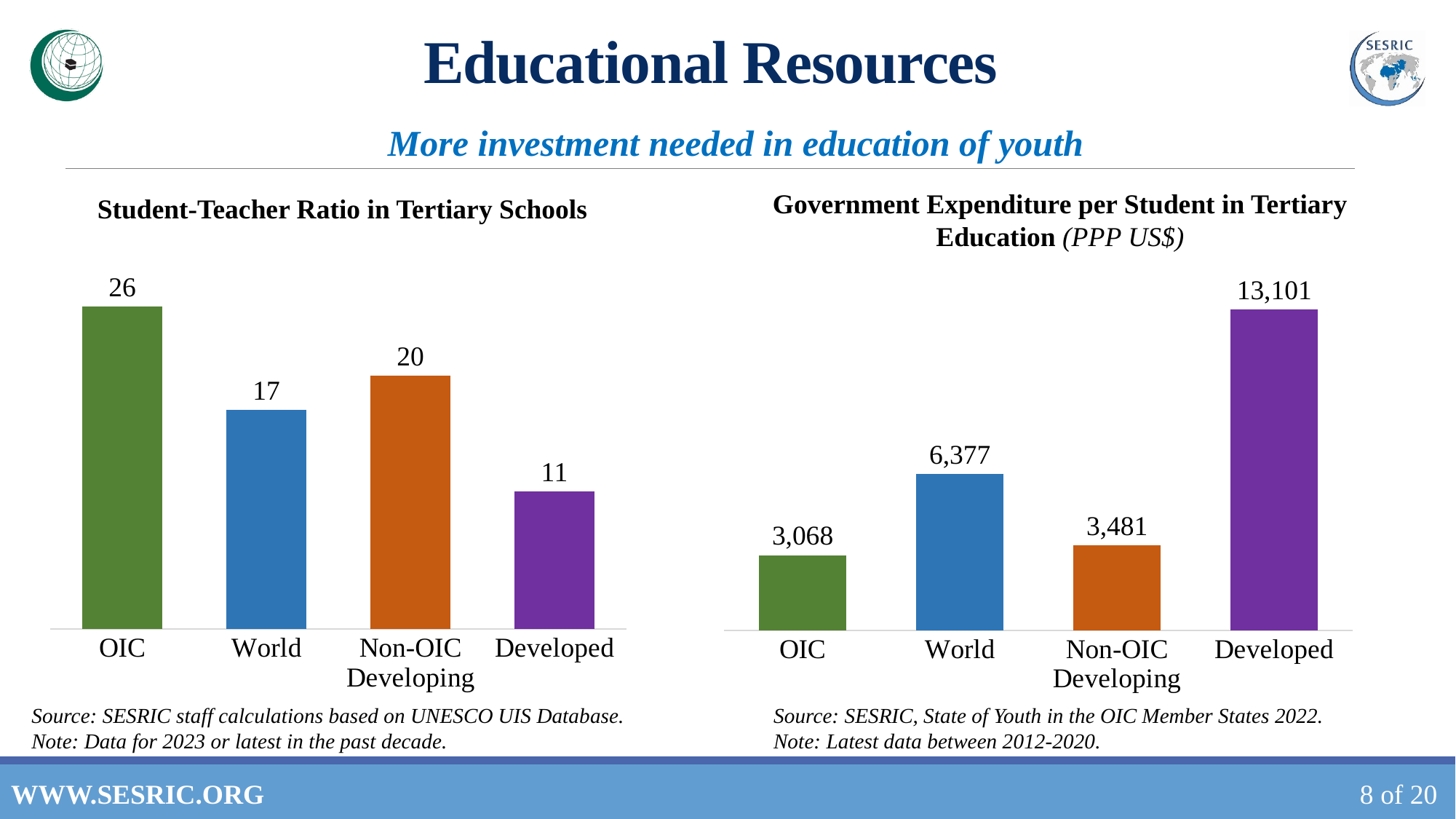
In the 'Government Expenditure per Student in Tertiary Education (PPP US$)' chart, which category has the highest value? Developed In the 'Student-Teacher Ratio in Tertiary Schools' chart, how many categories are shown? 4 In the 'Student-Teacher Ratio in Tertiary Schools' chart, which is larger, World or Non-OIC Developing? Non-OIC Developing In the 'Government Expenditure per Student in Tertiary Education (PPP US$)' chart, what is the difference between the World and OIC values? 3,309 In the 'Government Expenditure per Student in Tertiary Education (PPP US$)' chart, what is the value for Developed? 13,101 What kind of chart is the 'Government Expenditure per Student in Tertiary Education (PPP US$)' chart? Bar chart In the 'Student-Teacher Ratio in Tertiary Schools' chart, what is the difference between the OIC and World values? 9 In the 'Student-Teacher Ratio in Tertiary Schools' chart, what is the value for OIC? 26 In the 'Student-Teacher Ratio in Tertiary Schools' chart, which category has the lowest value? Developed In the 'Government Expenditure per Student in Tertiary Education (PPP US$)' chart, which category has the lowest value? OIC In the 'Government Expenditure per Student in Tertiary Education (PPP US$)' chart, what is the value for Non-OIC Developing? 3,481 In the 'Student-Teacher Ratio in Tertiary Schools' chart, what colour is the Developed bar? Purple